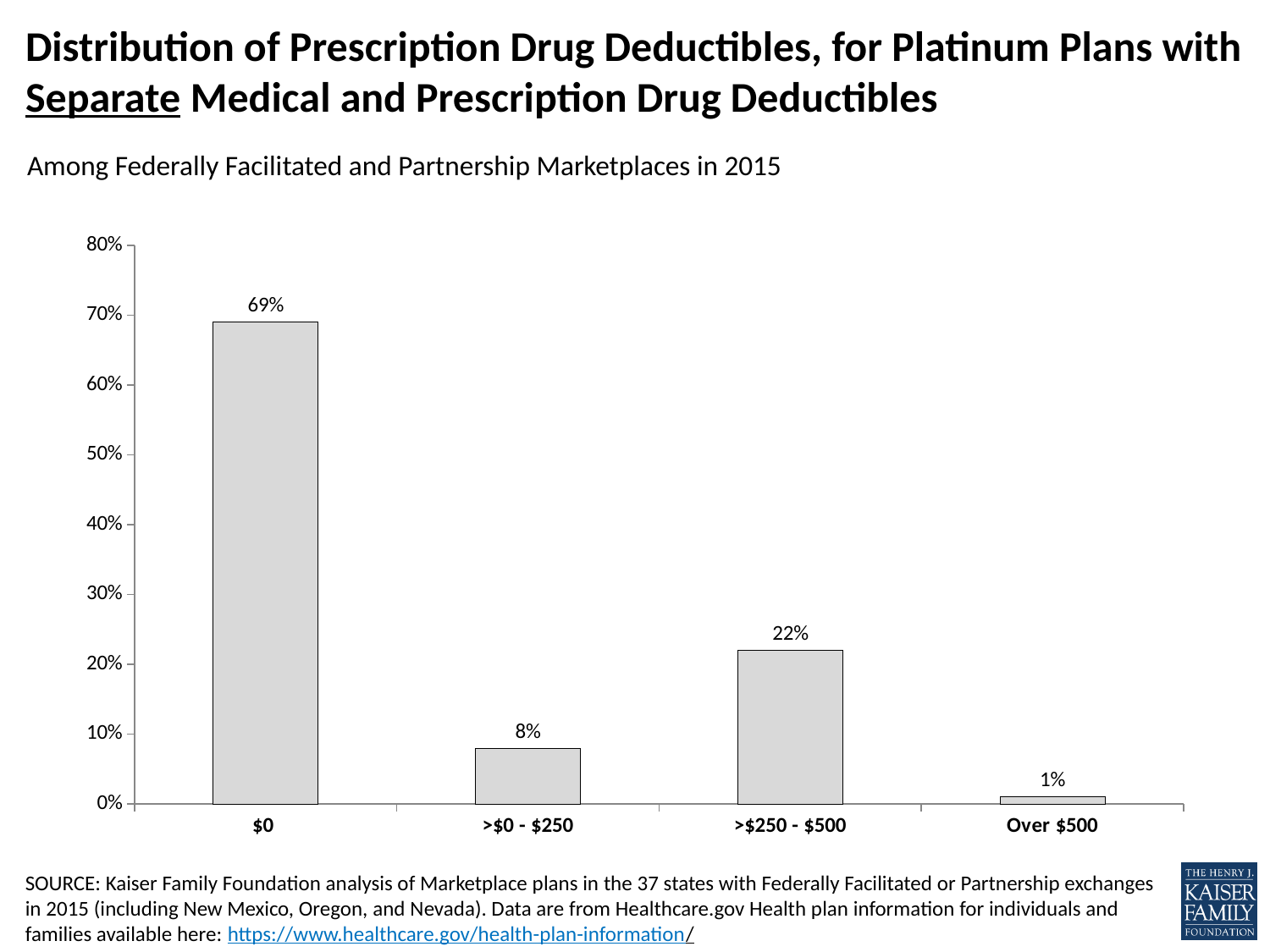
Which deductible category has the highest share of plans? $0 What is the value for the >$250 - $500 category? 22% What is the value for the Over $500 category? 1% What percentage of plans have a $0 prescription drug deductible? 69% What is the maximum value shown on the y axis? 80% Which is larger, the value for >$0 - $250 or the value for >$250 - $500? >$250 - $500 Which deductible category has the lowest share of plans? Over $500 What is the value for the >$0 - $250 category? 8% How many deductible categories are shown on the x axis? 4 What kind of chart is shown on the slide? Bar chart What is the difference in percentage points between the $0 category and the >$250 - $500 category? 47 Is the value for the $0 category greater or less than 60%? greater